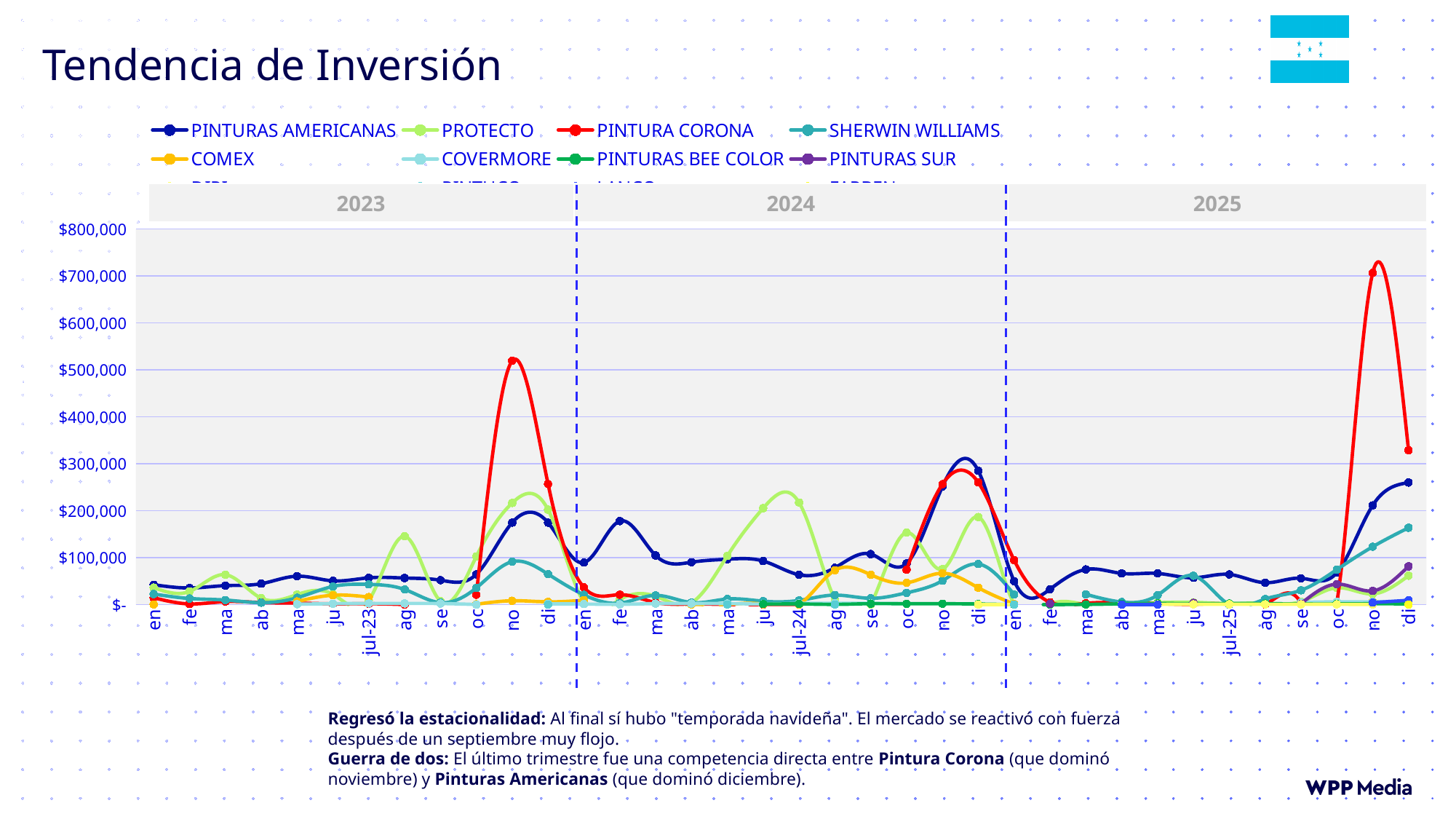
Is the value for PINTURAS AMERICANAS in December 2025 greater or less than $200,000? greater Is the value for PINTURA CORONA in November 2023 greater or less than $400,000? greater Is the value for PINTURA CORONA in November 2025 greater or less than $600,000? greater Which three years are marked across the top of the chart? 2023, 2024, 2025 Which series reaches the highest value anywhere on the chart? PINTURA CORONA What kind of chart is shown on the slide? line chart In which month and year does PINTURA CORONA reach its highest peak? November 2025 What is the title of the chart? Tendencia de Inversión Does the PINTURA CORONA line rise or fall from November 2025 to December 2025? fall In November 2023, which series has the higher value: PINTURA CORONA or PINTURAS AMERICANAS? PINTURA CORONA